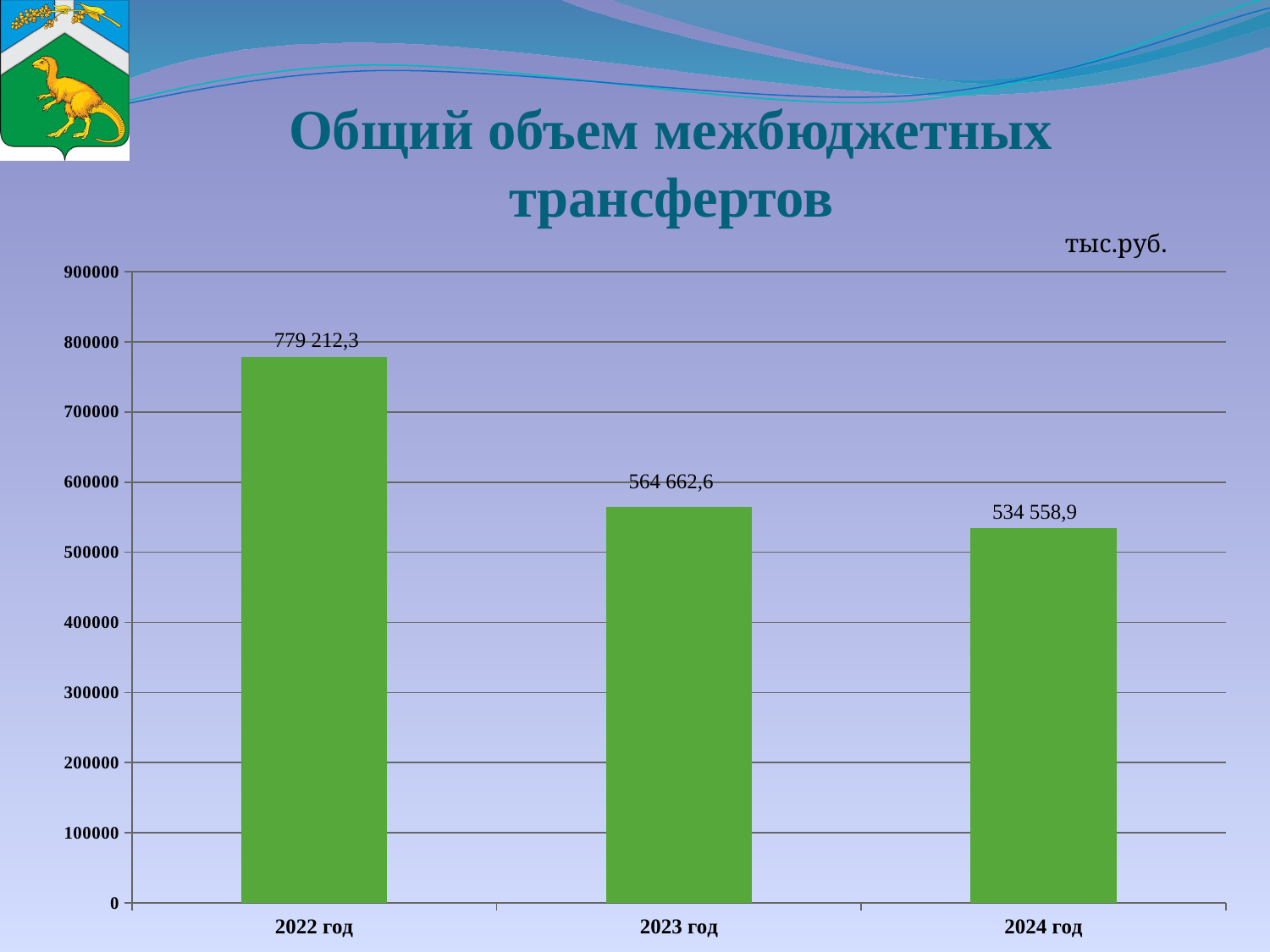
What kind of chart is shown on the slide? bar chart Do the values rise or fall from 2022 год to 2024 год? fall What is the difference between the values for 2023 год and 2024 год? 30 103,7 What is the difference between the values for 2022 год and 2023 год? 214 549,7 Which year has the lowest value? 2024 год Is the value for 2022 год greater or less than 700000? greater How many years are shown on the chart? 3 What is the value for 2023 год? 564 662,6 What is the value for 2022 год? 779 212,3 Which year has the highest value? 2022 год Which is larger, the value for 2023 год or the value for 2024 год? 2023 год What is the value for 2024 год? 534 558,9